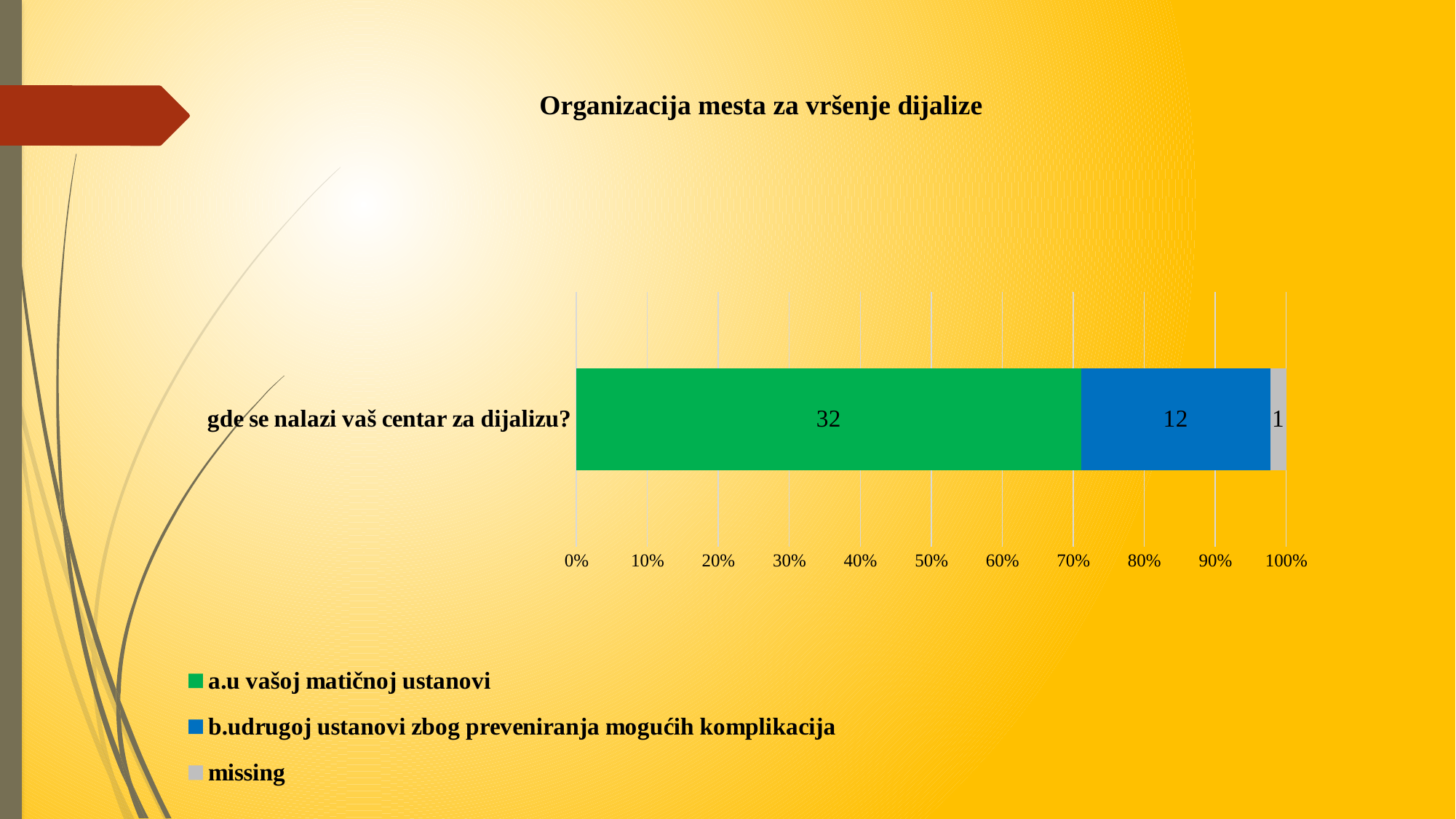
What is the difference between the values for 'a.u vašoj matičnoj ustanovi' and 'b.udrugoj ustanovi zbog preveniranja mogućih komplikacija'? 20 How many series does the legend list? 3 Which is larger: the value for 'b.udrugoj ustanovi zbog preveniranja mogućih komplikacija' or the value for 'missing'? b.udrugoj ustanovi zbog preveniranja mogućih komplikacija Which series has the lowest value in the chart? missing How many categories are shown on the chart's vertical axis? 1 Which series has the highest value in the chart? a.u vašoj matičnoj ustanovi What is the title of the chart? Organizacija mesta za vršenje dijalize What kind of chart is shown on the slide? Stacked bar chart What is the value for 'b.udrugoj ustanovi zbog preveniranja mogućih komplikacija' in the chart? 12 What is the value for 'missing' in the chart? 1 What is the value for 'a.u vašoj matičnoj ustanovi' in the chart? 32 What is the total of all segments in the stacked bar? 45